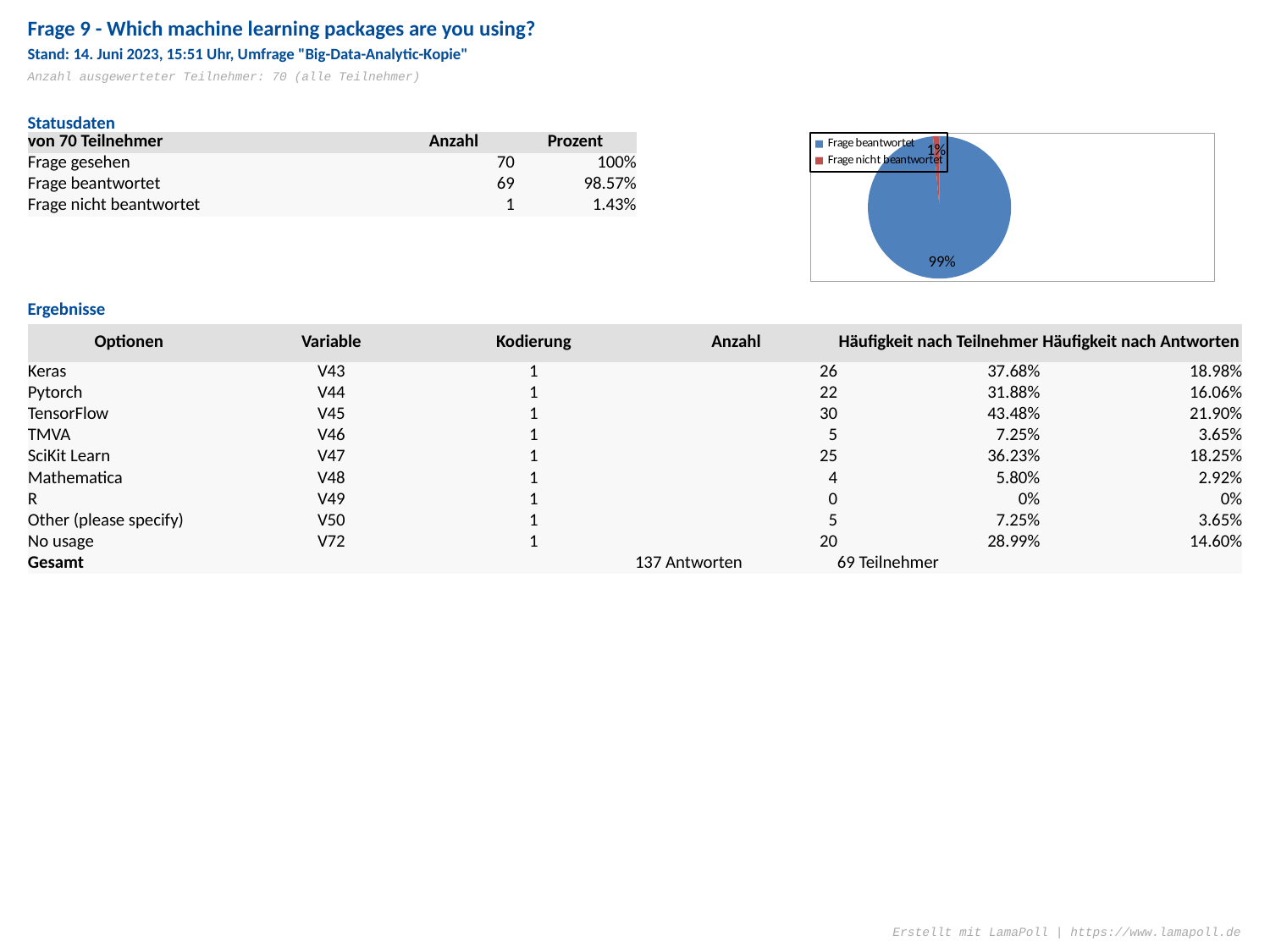
What colour is the "Frage beantwortet" slice in the pie chart? blue Which slice of the pie chart is the smallest? Frage nicht beantwortet What kind of chart is shown on the slide? pie chart How many entries does the pie chart's legend list? 2 What share of the pie chart is labelled for "Frage beantwortet"? 99% What is the difference in percentage points between the "Frage beantwortet" and "Frage nicht beantwortet" slices in the pie chart? 98 percentage points In the pie chart, which is larger: "Frage beantwortet" or "Frage nicht beantwortet"? Frage beantwortet What share of the pie chart is labelled for "Frage nicht beantwortet"? 1% How many slices does the pie chart have? 2 What are the two legend entries of the pie chart? Frage beantwortet, Frage nicht beantwortet Which slice of the pie chart is the largest? Frage beantwortet